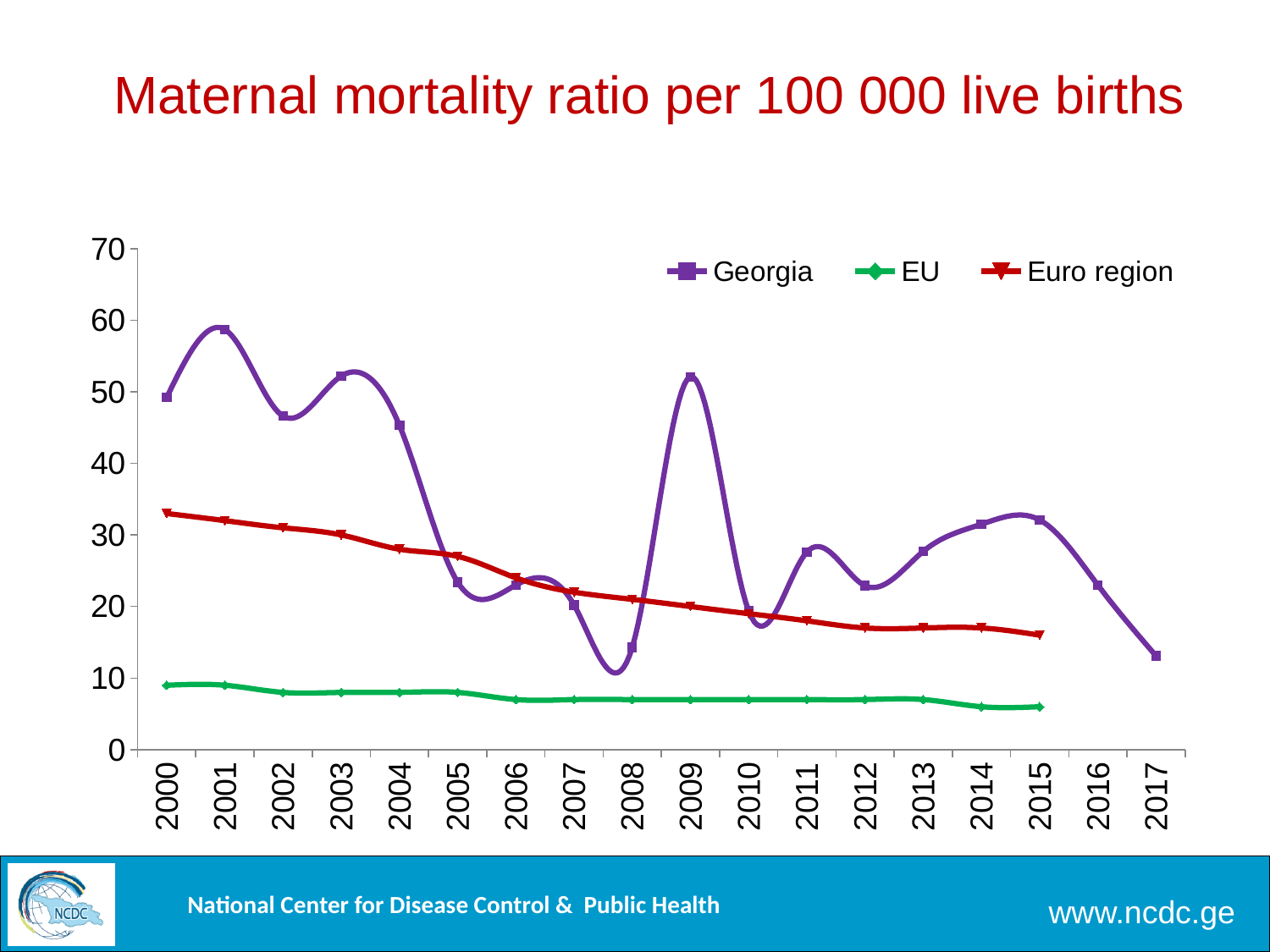
Is the value for Georgia in 2008 greater or less than 20? less What kind of chart is shown on the slide? line chart Which year has the highest value for Georgia? 2001 Is the value for Georgia in 2001 greater or less than 50? greater Is the value for EU in 2015 greater or less than 10? less In 2015, which is larger: the value for EU or the value for Euro region? Euro region Do the values for Euro region rise or fall from 2000 to 2015? fall How many series does the legend list? 3 What is the title of the chart? Maternal mortality ratio per 100 000 live births How many years are shown on the x axis? 18 In 2000, which is larger: the value for Georgia or the value for Euro region? Georgia